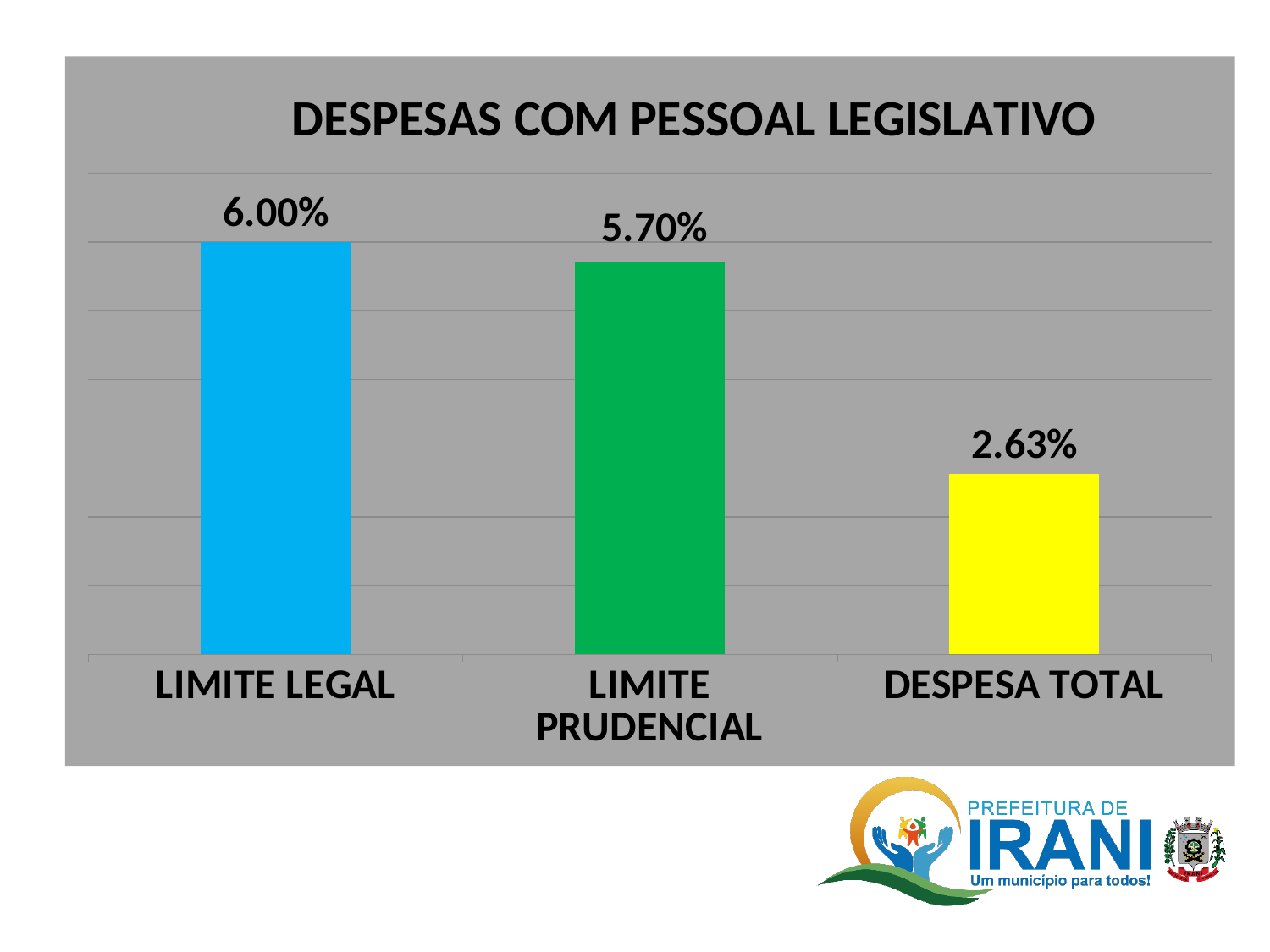
What is the difference between the values for LIMITE LEGAL and LIMITE PRUDENCIAL? 0.30% How many categories are shown in the chart? 3 What colour is the bar for DESPESA TOTAL? Yellow What is the value for LIMITE LEGAL? 6.00% What kind of chart is shown on the slide? Bar chart What is the value for LIMITE PRUDENCIAL? 5.70% What is the value for DESPESA TOTAL? 2.63% Which category has the highest value? LIMITE LEGAL What is the difference between the values for LIMITE LEGAL and DESPESA TOTAL? 3.37% Which category has the lowest value? DESPESA TOTAL What is the title of the chart? DESPESAS COM PESSOAL LEGISLATIVO Which is larger, the value for LIMITE PRUDENCIAL or the value for DESPESA TOTAL? LIMITE PRUDENCIAL